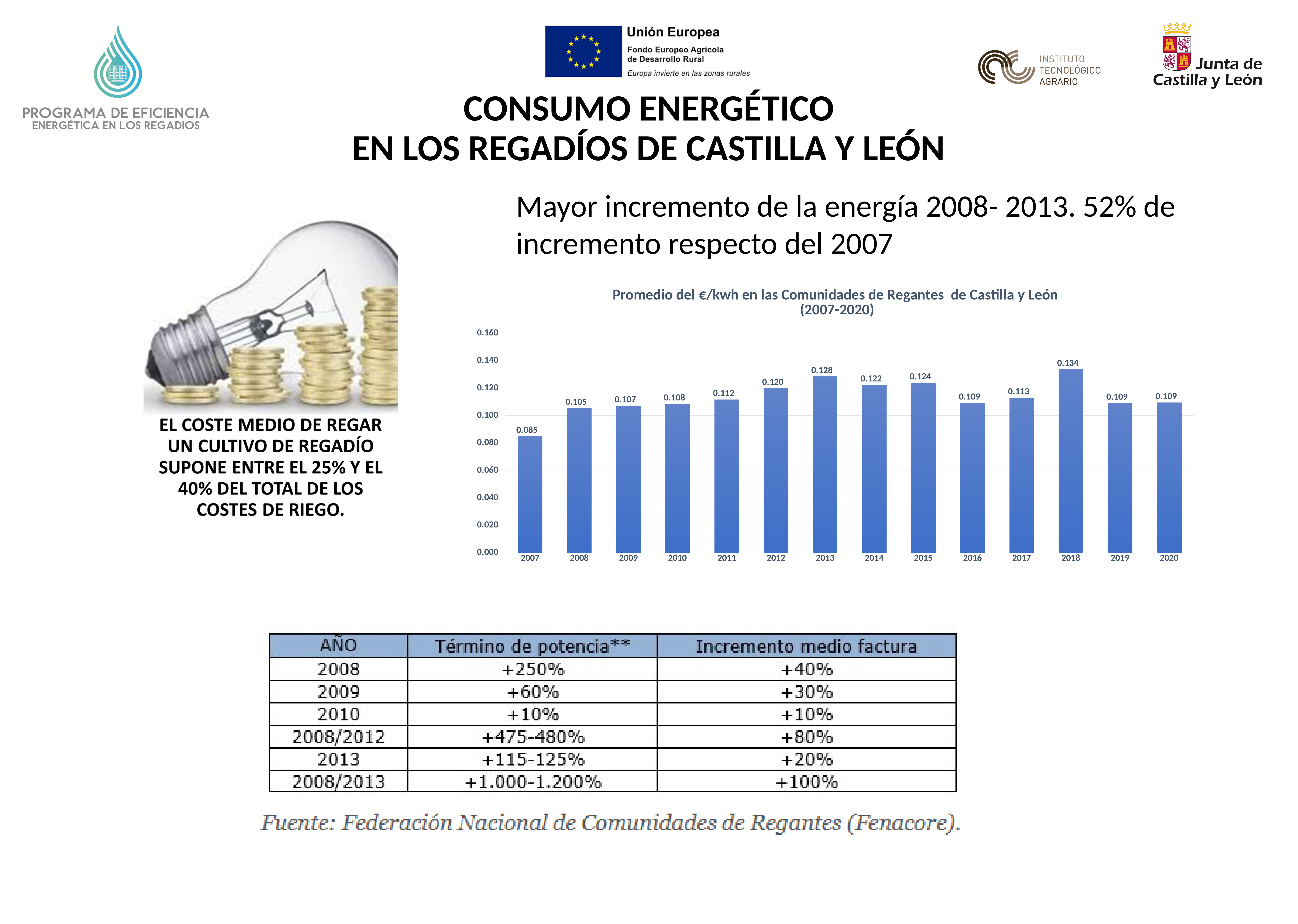
What is the title of the chart? Promedio del €/kwh en las Comunidades de Regantes de Castilla y León (2007-2020) Which is larger, the value for 2013 or the value for 2014? 2013 Which year has the highest value in the chart? 2018 Do the values rise or fall from 2007 to 2013? Rise What is the value for 2013 in the chart? 0.128 What is the difference between the values for 2018 and 2007? 0.049 How many years are shown on the x axis of the chart? 14 Which year has the lowest value in the chart? 2007 Is the value for 2012 greater or less than 0.100? greater What is the value for 2007 in the chart? 0.085 What kind of chart is shown on the slide? Bar chart What is the value for 2018 in the chart? 0.134